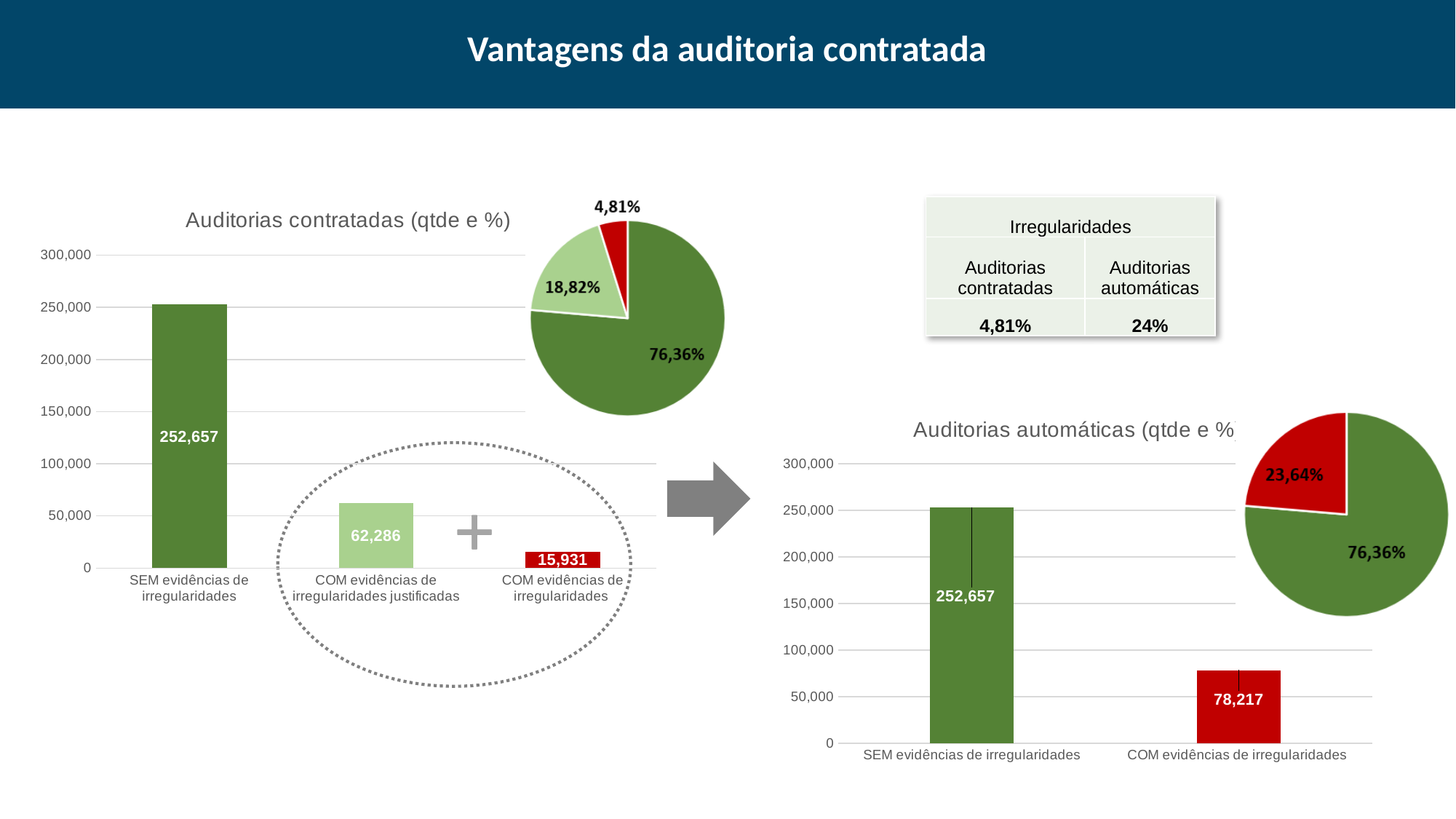
How many categories does the 'Auditorias contratadas (qtde e %)' bar chart show? 3 In the 'Auditorias contratadas (qtde e %)' bar chart, what is the value for 'COM evidências de irregularidades justificadas'? 62,286 In the 'Auditorias contratadas (qtde e %)' bar chart, what is the difference between 'COM evidências de irregularidades justificadas' and 'COM evidências de irregularidades'? 46,355 In the 'Auditorias automáticas (qtde e %)' bar chart, what is the difference between 'SEM evidências de irregularidades' and 'COM evidências de irregularidades'? 174,440 In the 'Auditorias automáticas (qtde e %)' bar chart, which category has the highest value? SEM evidências de irregularidades In the 'Auditorias automáticas (qtde e %)' bar chart, what is the value for 'COM evidências de irregularidades'? 78,217 In the pie chart next to the 'Auditorias automáticas' bar chart, what share does the red slice represent? 23,64% In the 'Auditorias contratadas (qtde e %)' bar chart, what is the value for 'COM evidências de irregularidades'? 15,931 In the 'Auditorias contratadas (qtde e %)' bar chart, what is the value for 'SEM evidências de irregularidades'? 252,657 What kind of chart is 'Auditorias automáticas (qtde e %)'? bar chart In the pie chart next to the 'Auditorias contratadas' bar chart, what share does the red slice represent? 4,81% In the 'Auditorias contratadas (qtde e %)' bar chart, which category has the lowest value? COM evidências de irregularidades